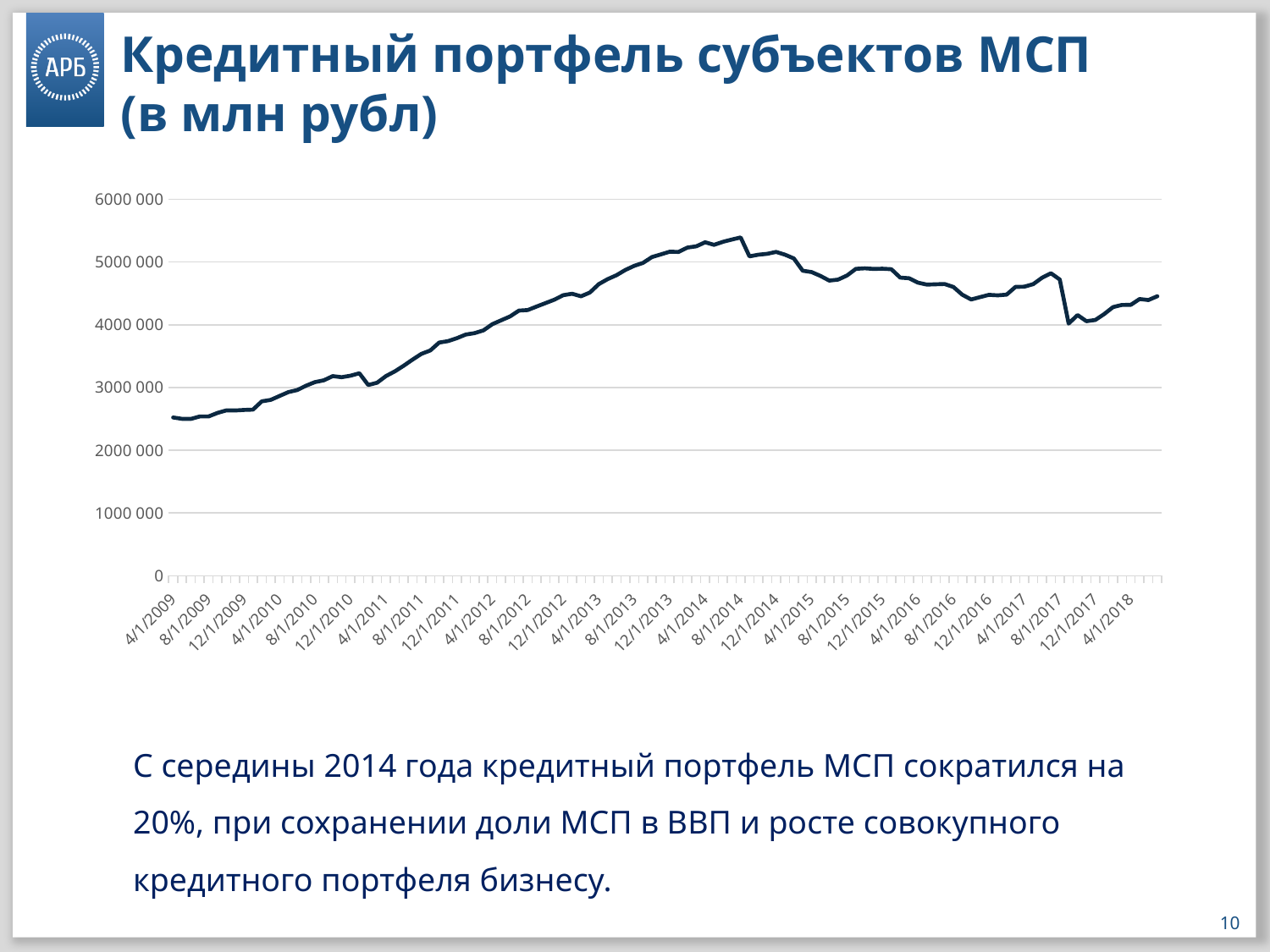
What kind of chart is shown on the slide? line chart Is the value for 4/1/2018 greater or less than 4000 000? greater Is the value for 4/1/2009 greater or less than 3000 000? less What is the title of the chart on the slide? Кредитный портфель субъектов МСП (в млн рубл) What is the highest value shown on the vertical axis of the chart? 6000 000 Is the value for 8/1/2014 greater or less than 5000 000? greater Around which date does the line reach its highest point? 8/1/2014 Which is larger, the value for 8/1/2014 or the value for 4/1/2016? 8/1/2014 Does the line rise or fall between 4/1/2009 and 8/1/2014? rise